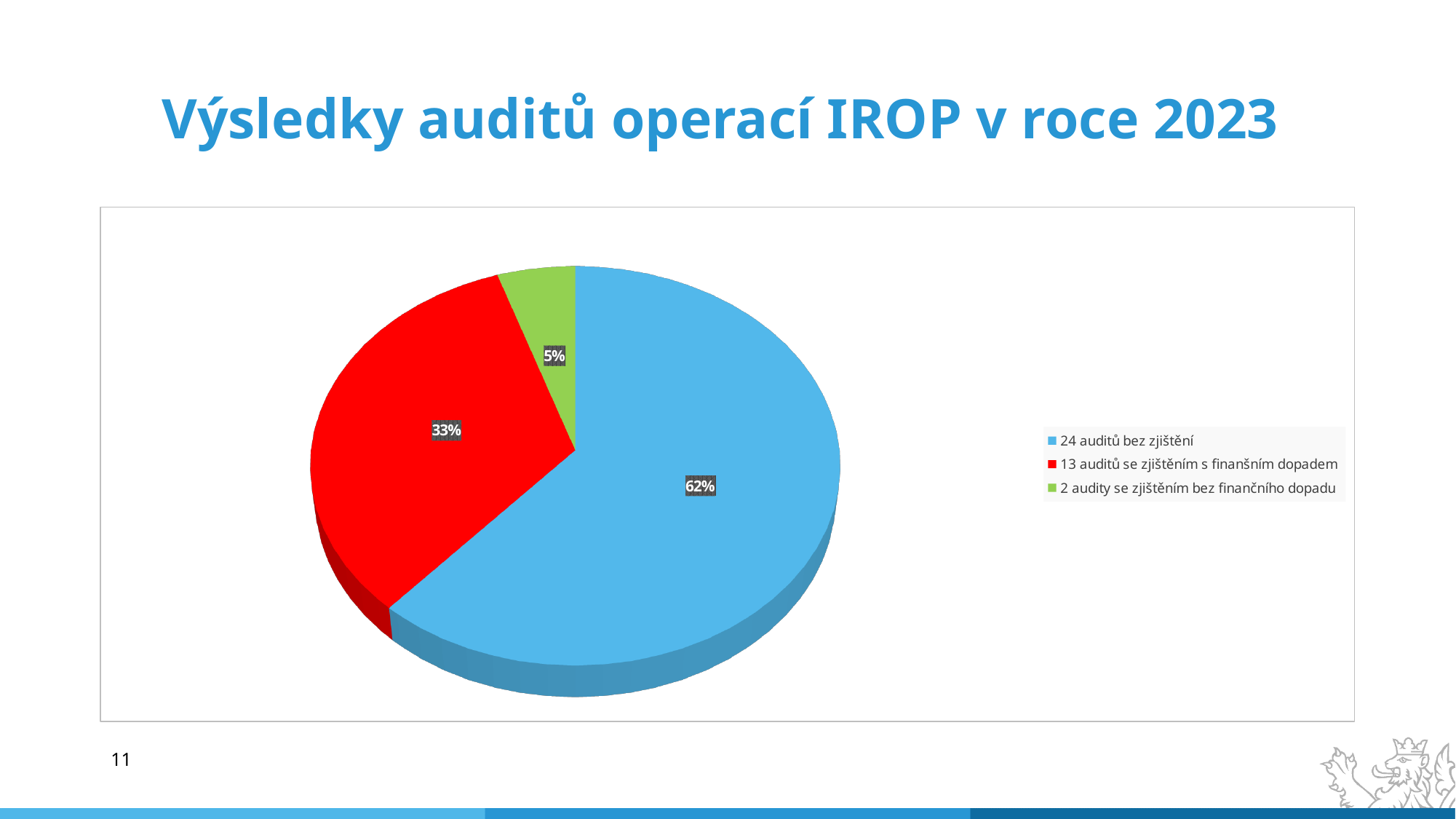
What is the difference in percentage points between the 62% slice and the 33% slice? 29 percentage points What is the title of the slide containing the chart? Výsledky auditů operací IROP v roce 2023 What share of the pie does "13 auditů se zjištěním s finanšním dopadem" represent? 33% Which slice is larger: "13 auditů se zjištěním s finanšním dopadem" or "2 audity se zjištěním bez finančního dopadu"? 13 auditů se zjištěním s finanšním dopadem Which category has the largest slice of the pie? 24 auditů bez zjištění What share of the pie does "24 auditů bez zjištění" represent? 62% What share of the pie does "2 audity se zjištěním bez finančního dopadu" represent? 5% Which category has the smallest slice of the pie? 2 audity se zjištěním bez finančního dopadu How many entries does the legend list? 3 How many slices does the pie chart have? 3 What colour is the slice for "13 auditů se zjištěním s finanšním dopadem"? red What kind of chart is shown on the slide? pie chart